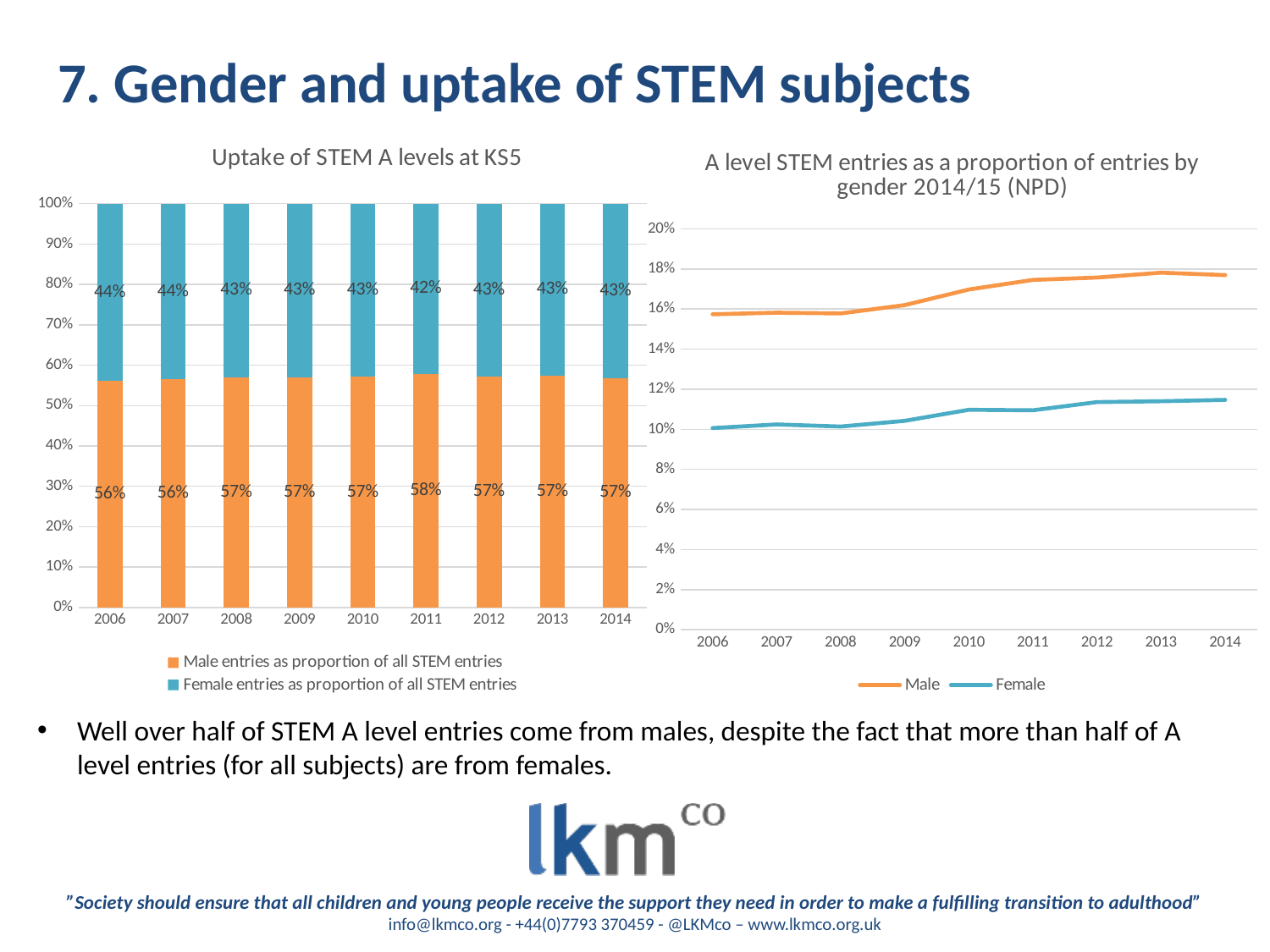
In the 'A level STEM entries as a proportion of entries by gender 2014/15 (NPD)' chart, is the Female value for 2014 greater or less than 10%? greater In the 'A level STEM entries as a proportion of entries by gender 2014/15 (NPD)' chart, which series is higher in 2010, Male or Female? Male In the 'A level STEM entries as a proportion of entries by gender 2014/15 (NPD)' chart, is the Male value for 2006 greater or less than 16%? less What type of chart is 'Uptake of STEM A levels at KS5'? Stacked bar chart In the 'Uptake of STEM A levels at KS5' chart, what is the male entries proportion in 2011? 58% In the 'Uptake of STEM A levels at KS5' chart, which year has the highest male entries proportion? 2011 In the 'Uptake of STEM A levels at KS5' chart, what is the total of the male and female proportions in 2008? 100% In the 'Uptake of STEM A levels at KS5' chart, what is the difference between the male and female proportions in 2014? 14% In the 'Uptake of STEM A levels at KS5' chart, what is the female entries proportion in 2011? 42% In the 'Uptake of STEM A levels at KS5' chart, what is the female entries proportion in 2006? 44% In the 'Uptake of STEM A levels at KS5' chart, how many years are shown on the x axis? 9 In the 'A level STEM entries as a proportion of entries by gender 2014/15 (NPD)' chart, does the Male line generally rise or fall from 2006 to 2014? Rise